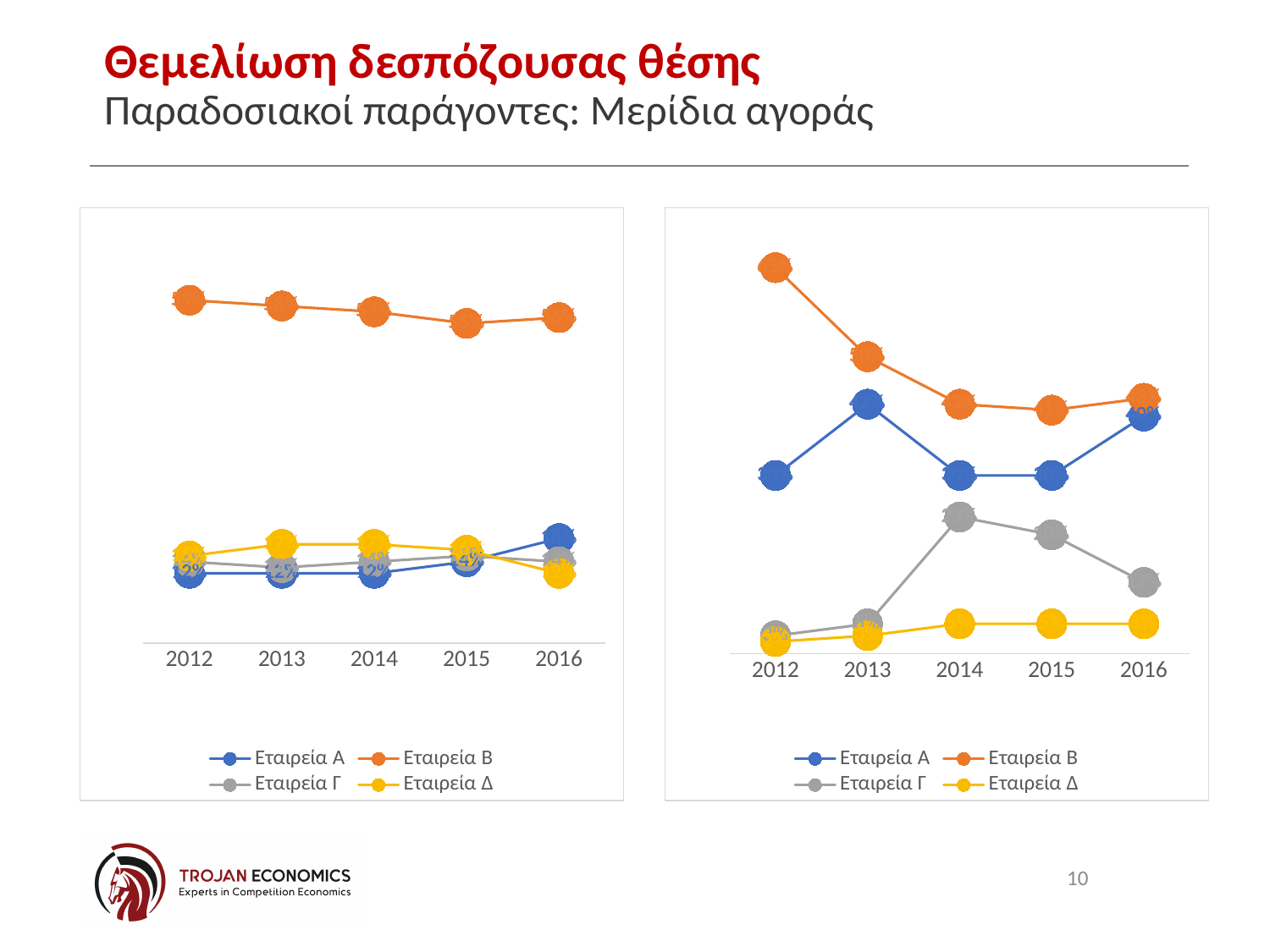
Which series is drawn in orange in the left chart's legend? Εταιρεία Β What kind of chart is the right chart on the slide? line chart What kind of chart is the left chart on the slide? line chart How many years are shown on the x axis of the right chart? 5 In the right chart, which series has the lowest value in 2015? Εταιρεία Δ In the right chart, which is larger in 2014: Εταιρεία Γ or Εταιρεία Δ? Εταιρεία Γ In the left chart, which is larger in 2016: Εταιρεία Α or Εταιρεία Δ? Εταιρεία Α In the right chart, does the value for Εταιρεία Β rise or fall from 2012 to 2015? fall How many series does the legend of the left chart list? 4 In the right chart, does the value for Εταιρεία Γ rise or fall from 2014 to 2016? fall In the left chart, which series has the highest value in 2014? Εταιρεία Β In the right chart, which series has the highest value in 2012? Εταιρεία Β